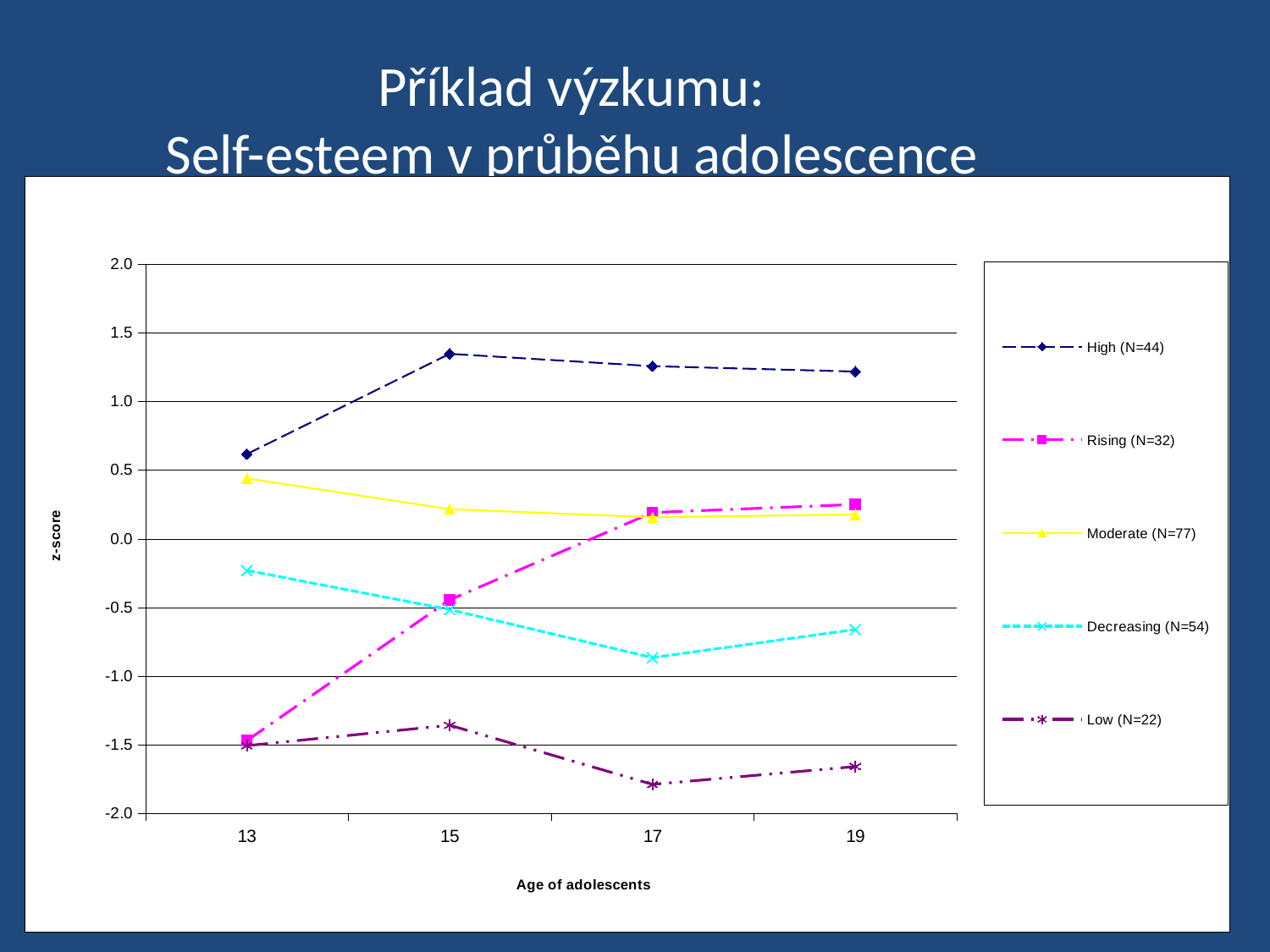
How many series does the legend list? 5 What is the label of the x axis? Age of adolescents Which group has the lowest z-score at age 19? Low (N=22) Is the z-score for the Rising (N=32) group at age 13 greater or less than -1.0? less Is the z-score for the Low (N=22) group at age 17 greater or less than -1.5? less Does the z-score of the Rising (N=32) group rise or fall from age 13 to age 19? rise Is the z-score for the Decreasing (N=54) group at age 17 greater or less than -0.5? less What kind of chart is shown on the slide? line chart How many age points are plotted along the x axis? 4 At age 19, which group has the larger z-score, Rising (N=32) or Decreasing (N=54)? Rising (N=32) Which group has the highest z-score at age 19? High (N=44)